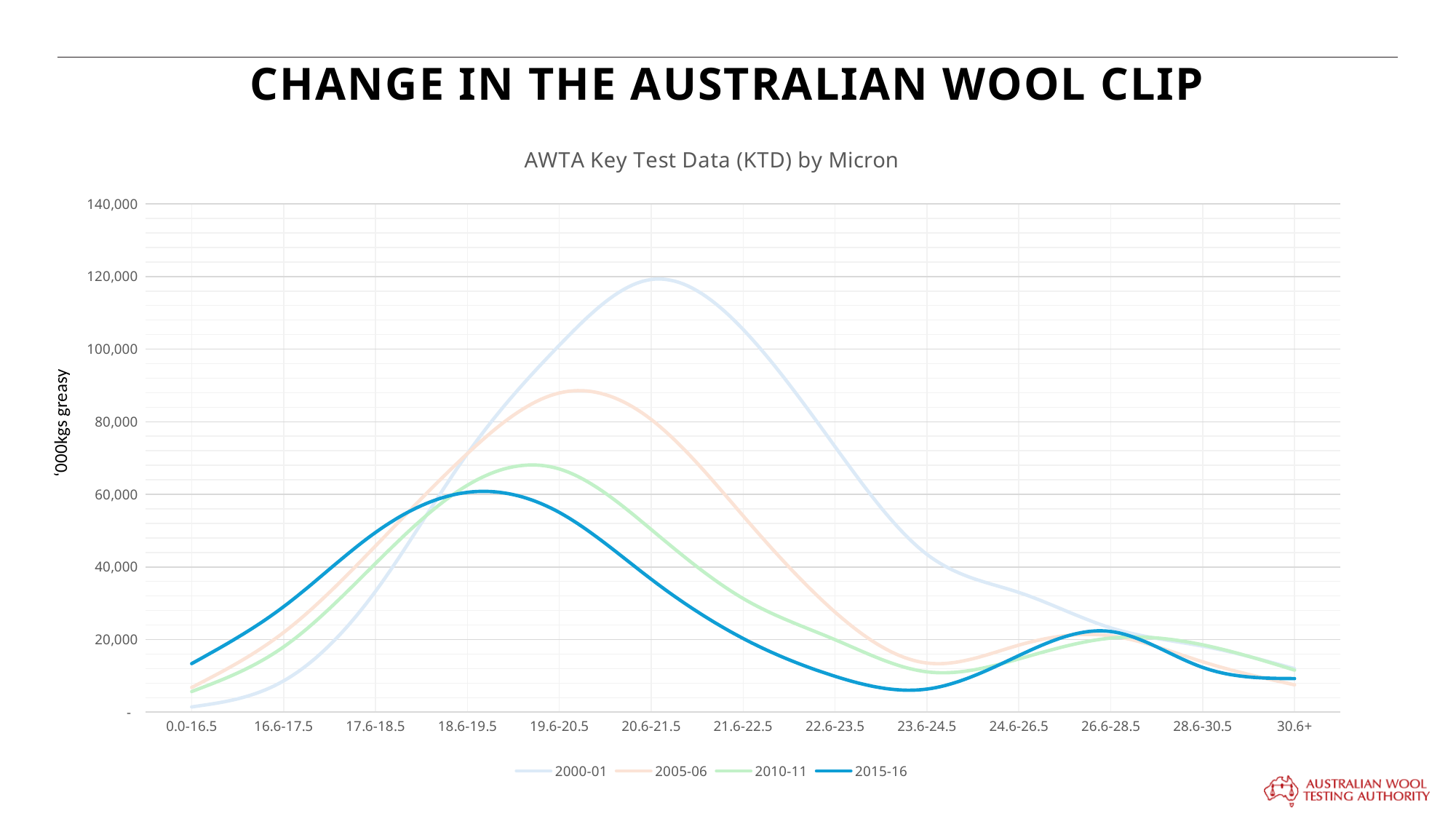
Is the value for 2005-06 at 19.6-20.5 greater or less than 80,000? greater How many series does the legend list? 4 At 0.0-16.5, which series has the larger value: 2000-01 or 2015-16? 2015-16 What is the label on the y axis? '000kgs greasy In which micron category does the 2000-01 series reach its highest value? 20.6-21.5 How many micron categories are shown on the x axis? 13 What kind of chart is shown on the slide? Line chart Is the value for 2015-16 at 23.6-24.5 greater or less than 20,000? less Which series has the lowest value at 0.0-16.5? 2000-01 Which series reaches the highest value on the chart? 2000-01 In which micron category does the 2015-16 series reach its highest value? 18.6-19.5 Is the value for 2000-01 at 20.6-21.5 greater or less than 100,000? greater